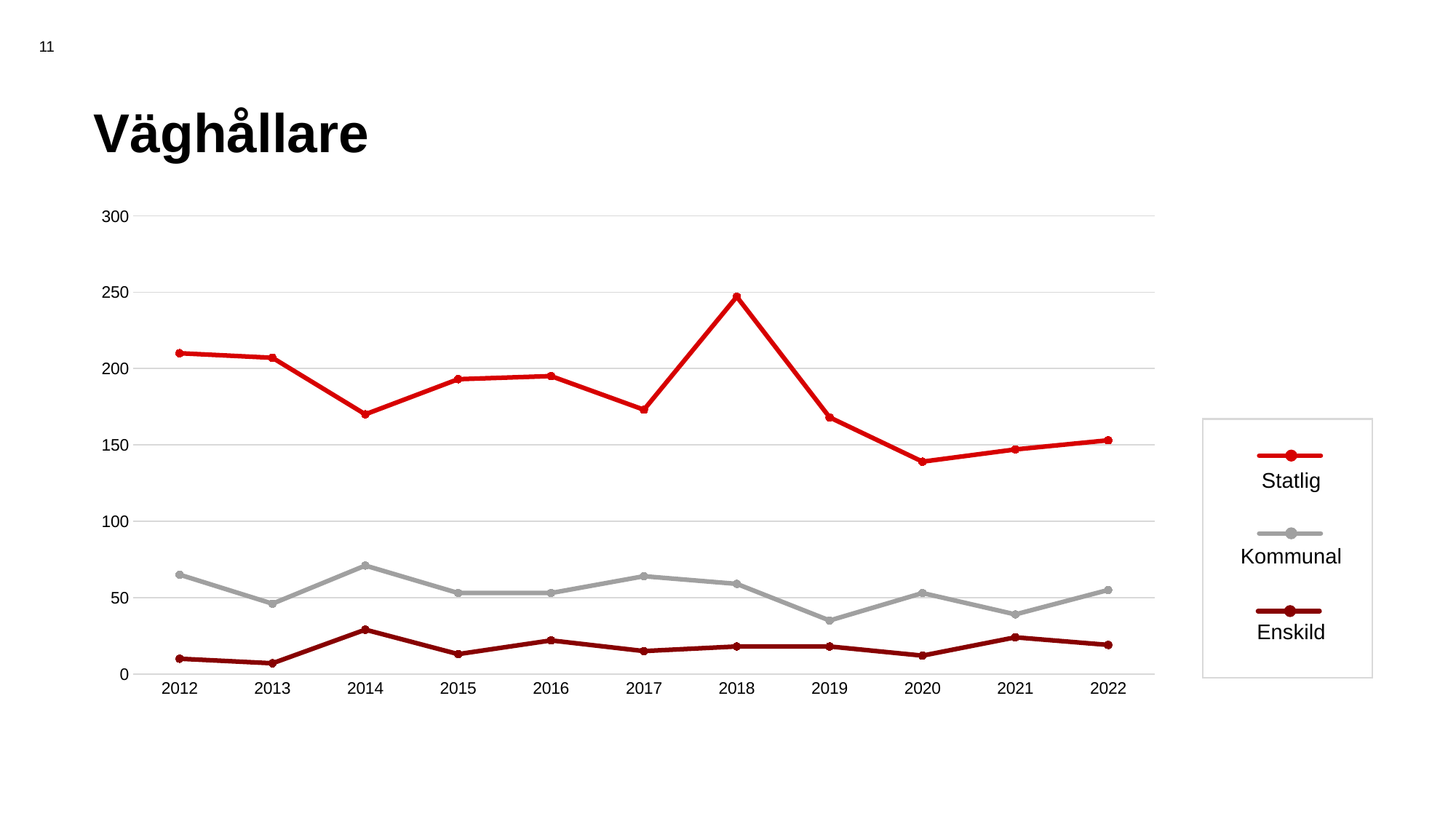
Which series has the larger value in 2016, Kommunal or Enskild? Kommunal How many years are plotted along the x axis? 11 In which year does the Statlig series reach its highest value? 2018 In which year does the Statlig series reach its lowest value? 2020 What kind of chart is shown on the slide? line chart Is the value for Kommunal in 2019 greater or less than 50? less Is the value for Enskild in 2014 greater or less than 50? less Is the value for Statlig in 2020 greater or less than 150? less How many series does the legend list? 3 Does the Statlig series rise or fall from 2018 to 2020? fall What is the title of the slide containing the chart? Väghållare